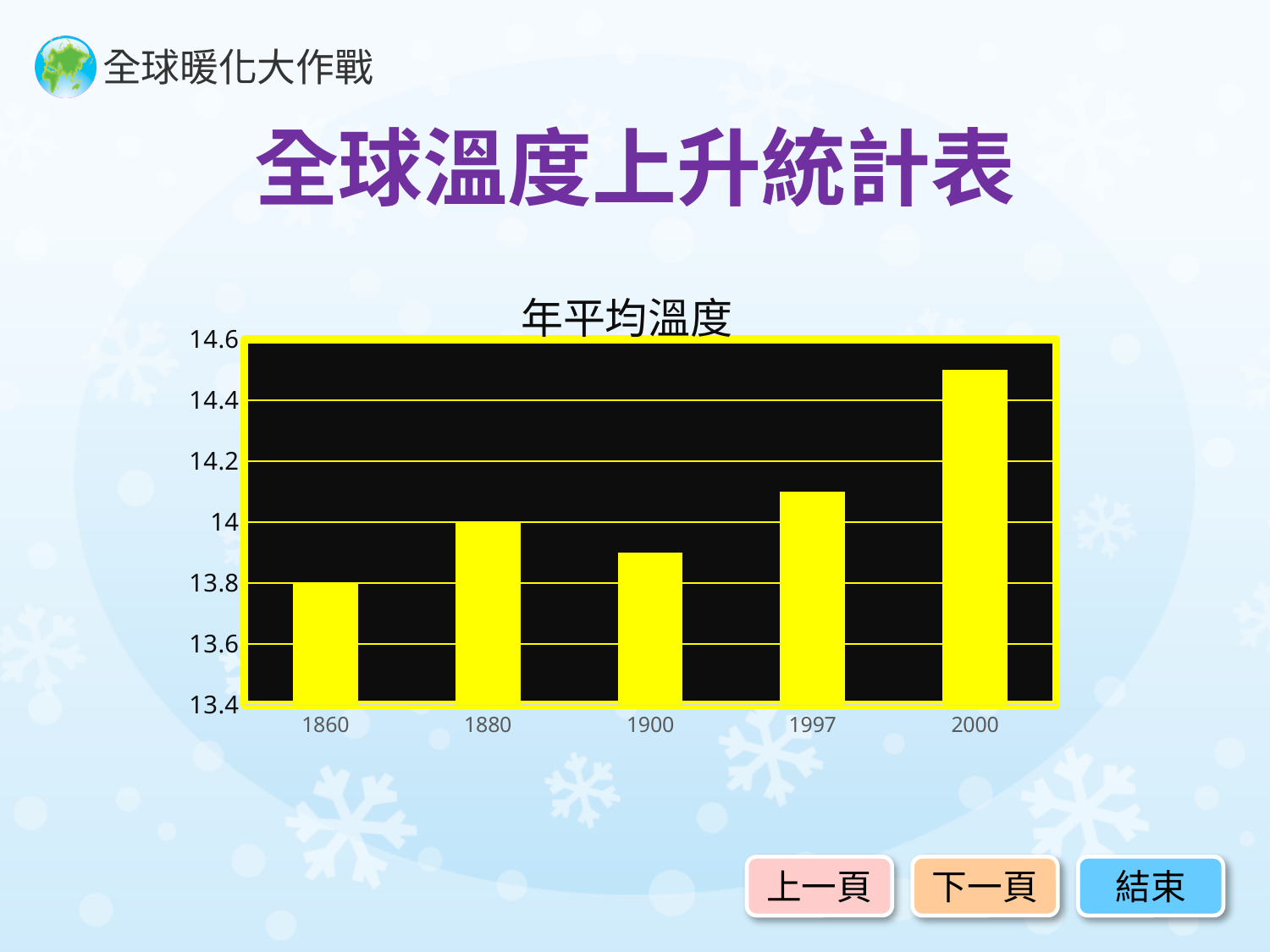
Which year has the highest bar? 2000 What is the value for 1880? 14 Do the values generally rise or fall from 1860 to 2000? rise What type of chart is shown on the slide? bar chart Is the value for 2000 greater or less than 14.4? greater Which year has the lowest bar? 1860 Is the value for 1900 greater or less than 14? less What is the title of the chart? 年平均溫度 Which is larger, the value for 1997 or the value for 1900? 1997 What is the difference between the values for 1880 and 1860? 0.2 What is the value for 1860? 13.8 How many years are shown on the x axis of the chart? 5